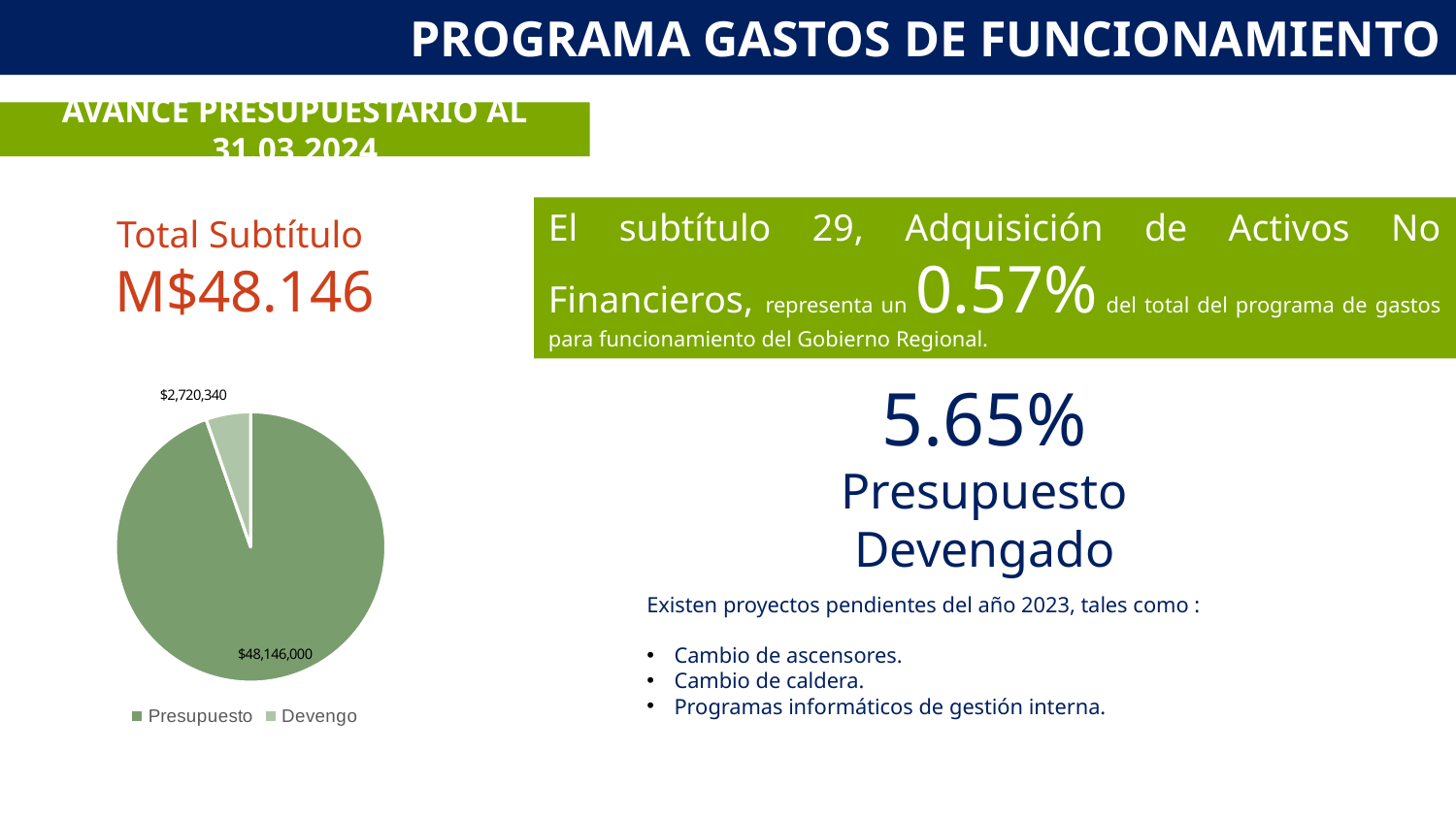
What kind of chart is shown on the slide? pie chart What is the value shown for Presupuesto in the pie chart? $48,146,000 What is the difference between the Presupuesto value and the Devengo value in the pie chart? $45,425,660 How many slices does the pie chart have? 2 Which slice of the pie chart is the largest? Presupuesto What is the value shown for Devengo in the pie chart? $2,720,340 Which slice of the pie chart is the smallest? Devengo What are the two legend entries of the pie chart? Presupuesto and Devengo Which legend entry of the pie chart is shown in the lighter green colour? Devengo How many entries does the legend of the pie chart list? 2 Which is larger in the pie chart, Presupuesto or Devengo? Presupuesto